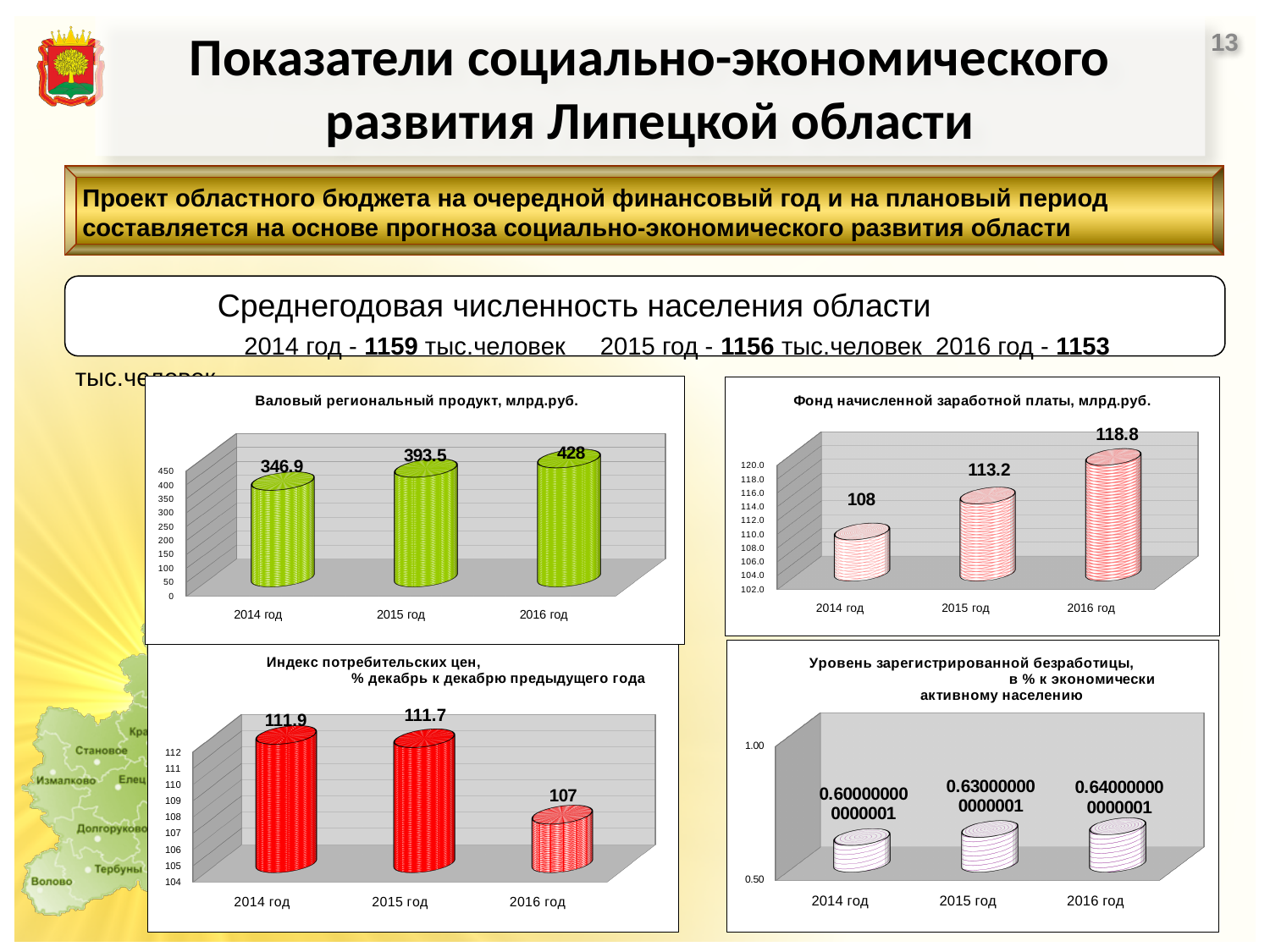
In the chart titled "Фонд начисленной заработной платы, млрд.руб.", what is the difference between the values for 2016 год and 2015 год? 5.6 In the chart titled "Индекс потребительских цен", which year has the lowest value? 2016 год In the chart titled "Валовый региональный продукт, млрд.руб.", do the values rise or fall from 2014 год to 2016 год? rise In the chart titled "Валовый региональный продукт, млрд.руб.", what is the value for 2015 год? 393.5 In the chart titled "Уровень зарегистрированной безработицы", which year has the lowest value? 2014 год In the chart titled "Индекс потребительских цен", which is larger, the value for 2014 год or for 2015 год? 2014 год In the chart titled "Индекс потребительских цен", what is the value for 2016 год? 107 In the chart titled "Фонд начисленной заработной платы, млрд.руб.", what is the value for 2014 год? 108 In the chart titled "Фонд начисленной заработной платы, млрд.руб.", which year has the highest value? 2016 год What kind of chart is the chart titled "Индекс потребительских цен"? bar chart In the chart titled "Валовый региональный продукт, млрд.руб.", what is the difference between the values for 2016 год and 2014 год? 81.1 How many categories (years) are shown in the chart titled "Валовый региональный продукт, млрд.руб."? 3